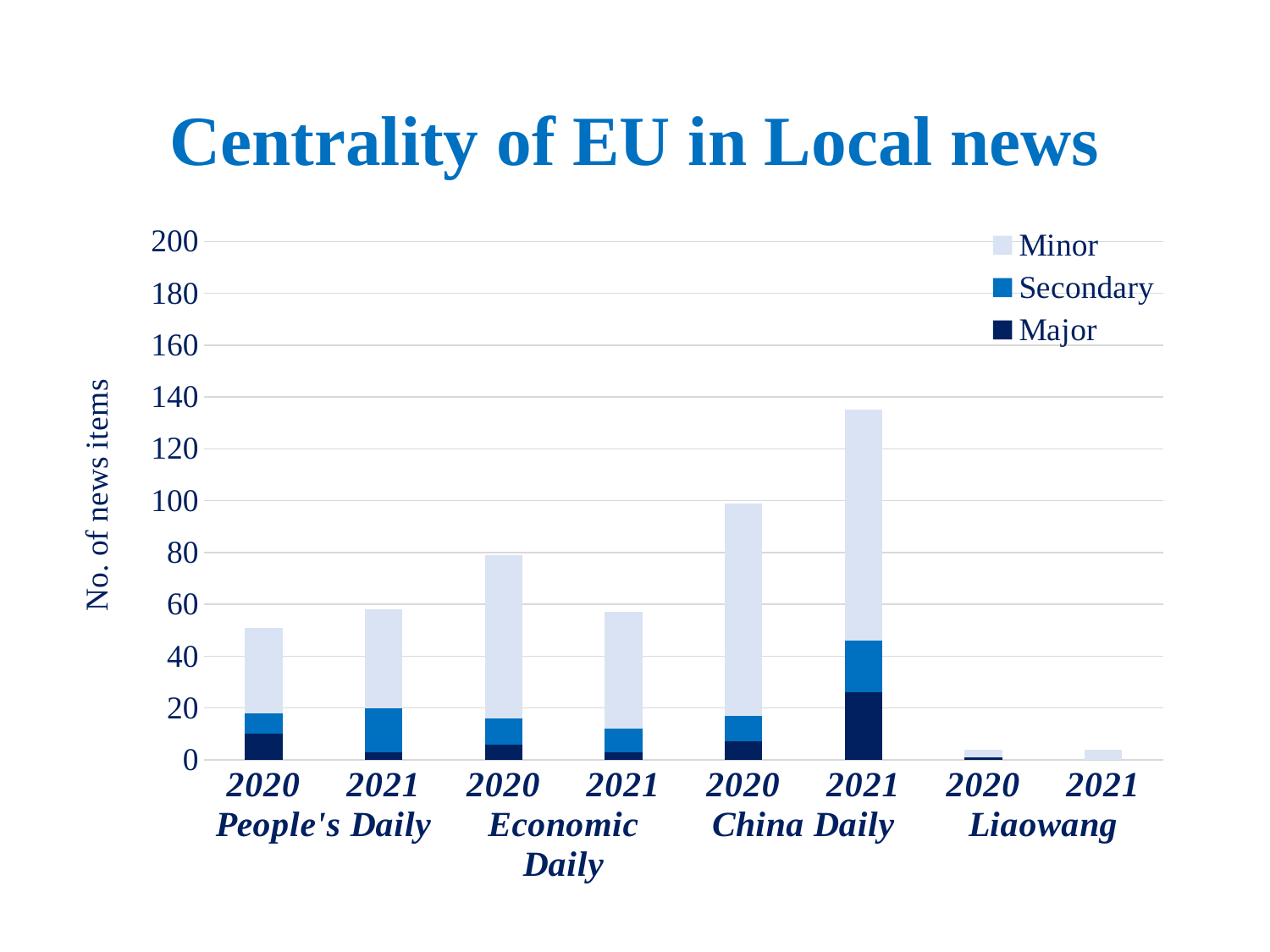
What kind of chart is shown on the slide? Stacked bar chart Which newspaper has the lowest totals in both years? Liaowang How many series does the legend list? 3 Is the total for China Daily 2021 greater or less than 120? greater Is the total for Economic Daily 2020 greater or less than 60? greater Which is larger, the total for China Daily 2020 or China Daily 2021? China Daily 2021 What is the label of the vertical axis? No. of news items How many bars are plotted in the chart? 8 Which bar has the highest total number of news items? China Daily 2021 Is the total for Liaowang 2021 greater or less than 20? less Which is larger, the total for Economic Daily 2020 or Economic Daily 2021? Economic Daily 2020